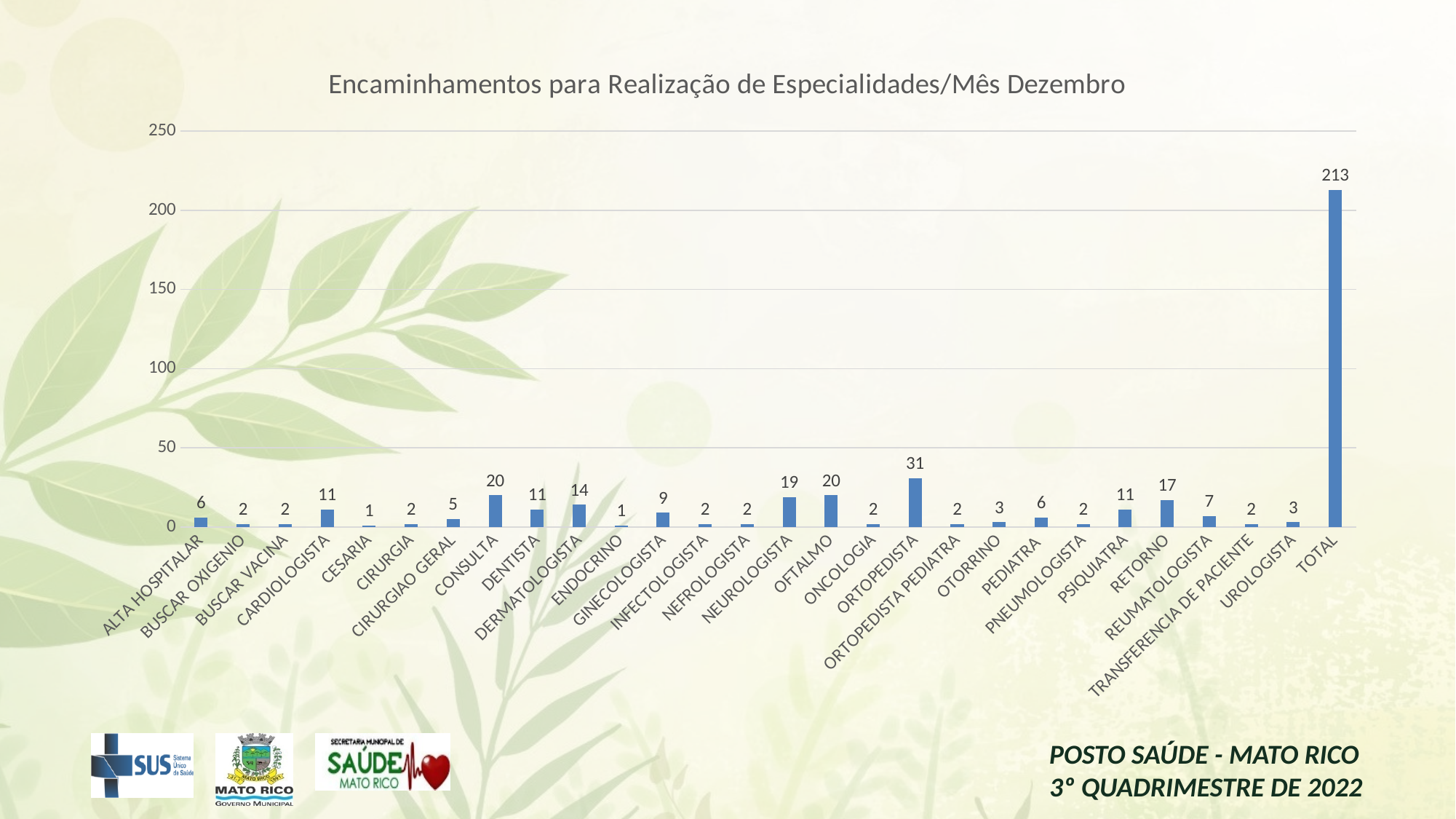
How many categories are shown on the x axis? 28 Which is larger, the value for CONSULTA or the value for GINECOLOGISTA? CONSULTA Excluding the TOTAL bar, which specialty has the highest value? ORTOPEDISTA Which category has the highest bar? TOTAL What is the title of the chart? Encaminhamentos para Realização de Especialidades/Mês Dezembro What kind of chart is shown on the slide? Bar chart What is the value for ORTOPEDISTA? 31 Is the value for TOTAL greater or less than 200? greater What is the value shown for the TOTAL bar? 213 What is the value for DERMATOLOGISTA? 14 What is the difference between the values for ORTOPEDISTA and NEUROLOGISTA? 12 What is the value for RETORNO? 17